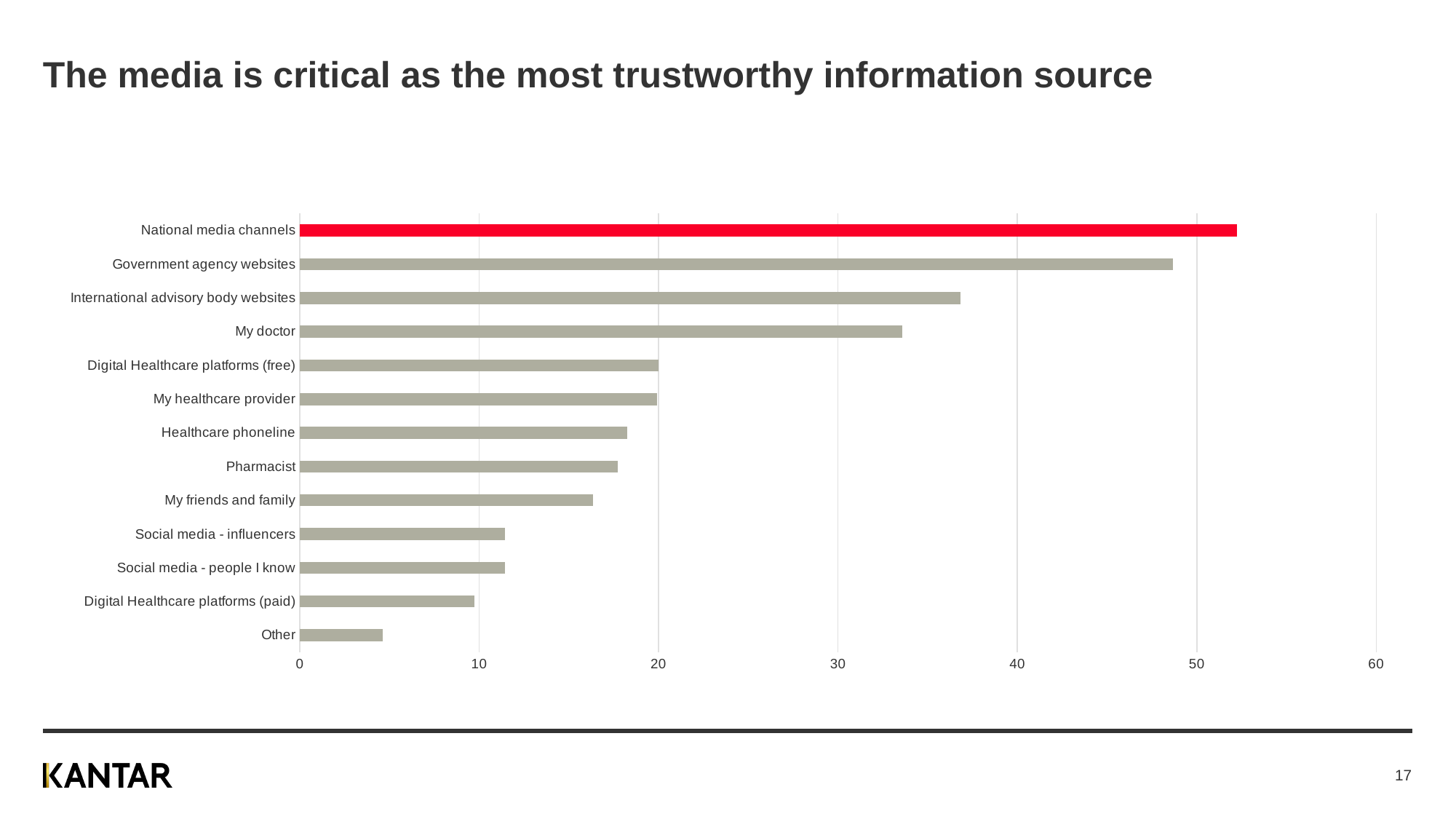
Which is larger, the value for Pharmacist or the value for My friends and family? Pharmacist Is the value for Other greater or less than 10? less How many categories are plotted in the chart? 13 Which category has the highest value in the chart? National media channels Is the value for International advisory body websites greater or less than 40? less Which is larger, the value for My doctor or the value for International advisory body websites? International advisory body websites Is the value for National media channels greater or less than 50? greater Which category has the lowest value in the chart? Other What kind of chart is shown on the slide? bar chart Which bar in the chart is coloured red rather than grey? National media channels